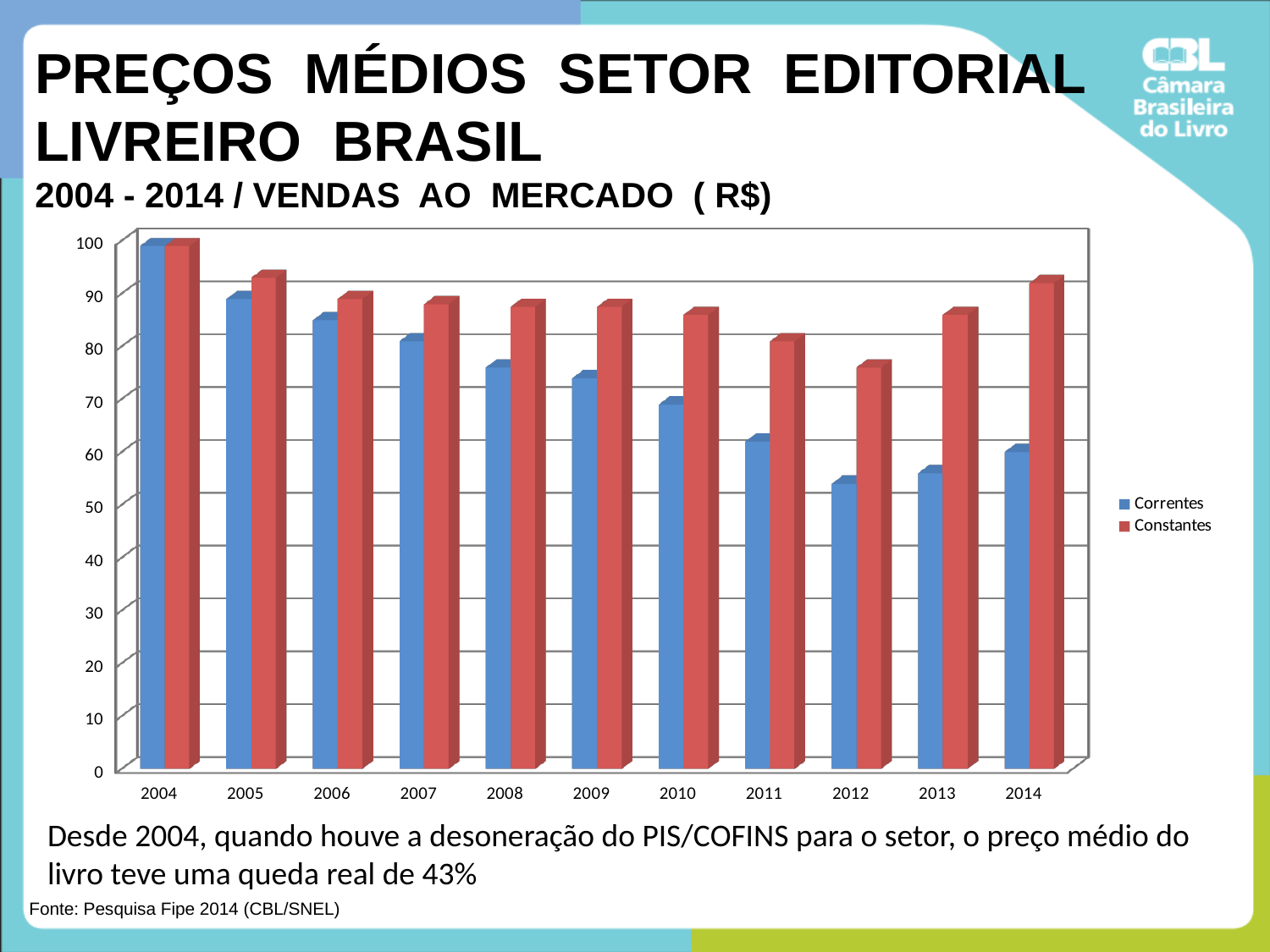
Which year has the lowest Correntes value? 2012 Is the Constantes value for 2014 greater or less than 90? greater What kind of chart is shown on the slide? bar chart How many years are shown on the x axis of the chart? 11 Which year has the highest Constantes value? 2004 Which year has the lowest Constantes value? 2012 How many series does the legend list? 2 Which year has the highest Correntes value? 2004 Is the Correntes value for 2004 greater or less than 90? greater In 2014, which series has the larger value, Correntes or Constantes? Constantes Do the Correntes values rise or fall from 2004 to 2012? fall Is the Correntes value for 2012 greater or less than 60? less